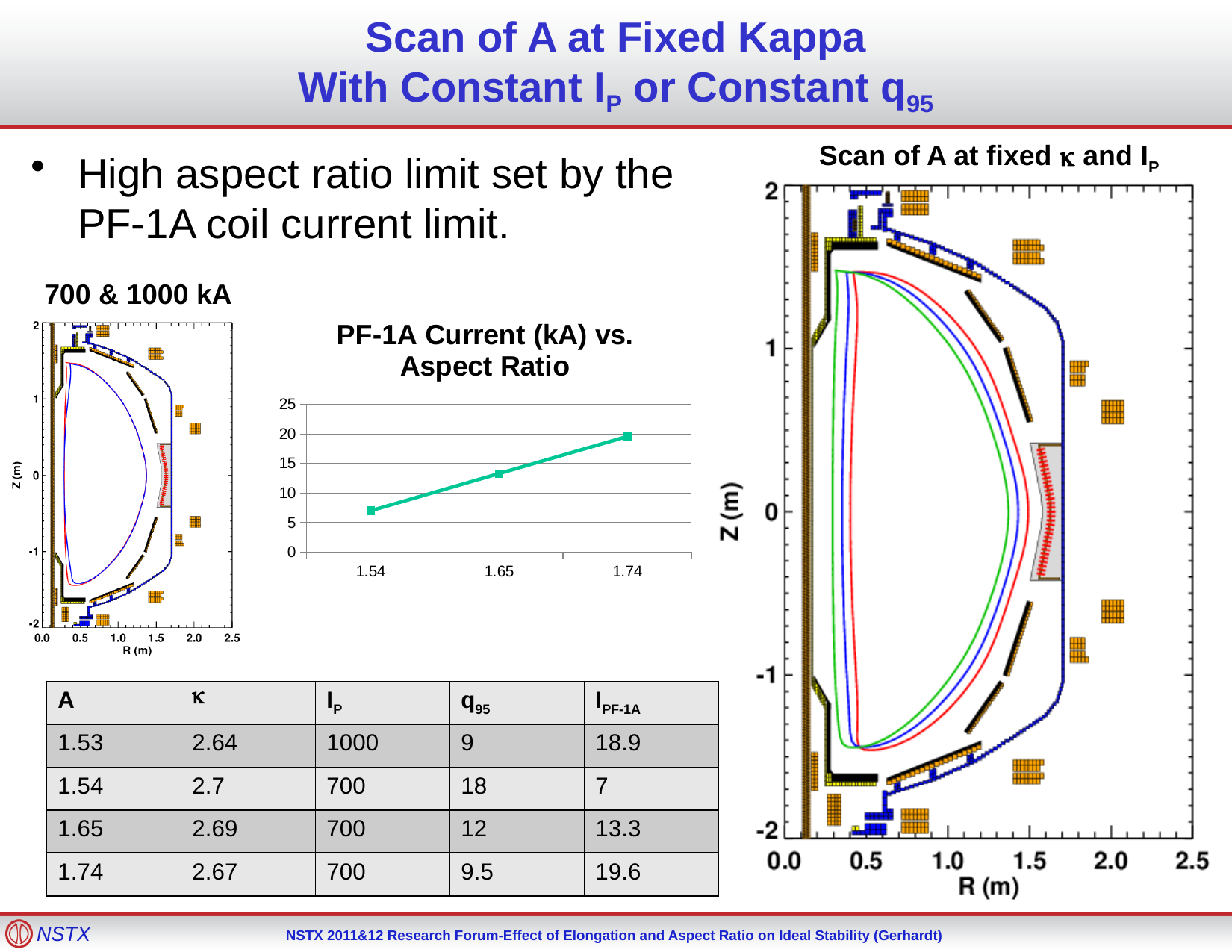
In the chart titled "PF-1A Current (kA) vs. Aspect Ratio", what is the maximum value shown on the y axis? 25 In the chart titled "PF-1A Current (kA) vs. Aspect Ratio", is the value at aspect ratio 1.74 greater or less than 15? greater In the chart titled "PF-1A Current (kA) vs. Aspect Ratio", is the value at aspect ratio 1.65 larger or smaller than the value at 1.74? smaller In the chart titled "PF-1A Current (kA) vs. Aspect Ratio", does the PF-1A current rise or fall as the aspect ratio increases? rise In the chart titled "PF-1A Current (kA) vs. Aspect Ratio", what kind of chart is it? line chart In the chart titled "PF-1A Current (kA) vs. Aspect Ratio", which aspect ratio has the lowest PF-1A current? 1.54 In the chart titled "PF-1A Current (kA) vs. Aspect Ratio", how many data points are plotted? 3 In the chart titled "PF-1A Current (kA) vs. Aspect Ratio", what are the aspect ratio values shown on the x axis? 1.54, 1.65, 1.74 In the chart titled "PF-1A Current (kA) vs. Aspect Ratio", is the value at aspect ratio 1.65 greater or less than 10? greater In the chart titled "PF-1A Current (kA) vs. Aspect Ratio", is the value at aspect ratio 1.54 greater or less than 10? less In the chart titled "PF-1A Current (kA) vs. Aspect Ratio", which aspect ratio has the highest PF-1A current? 1.74